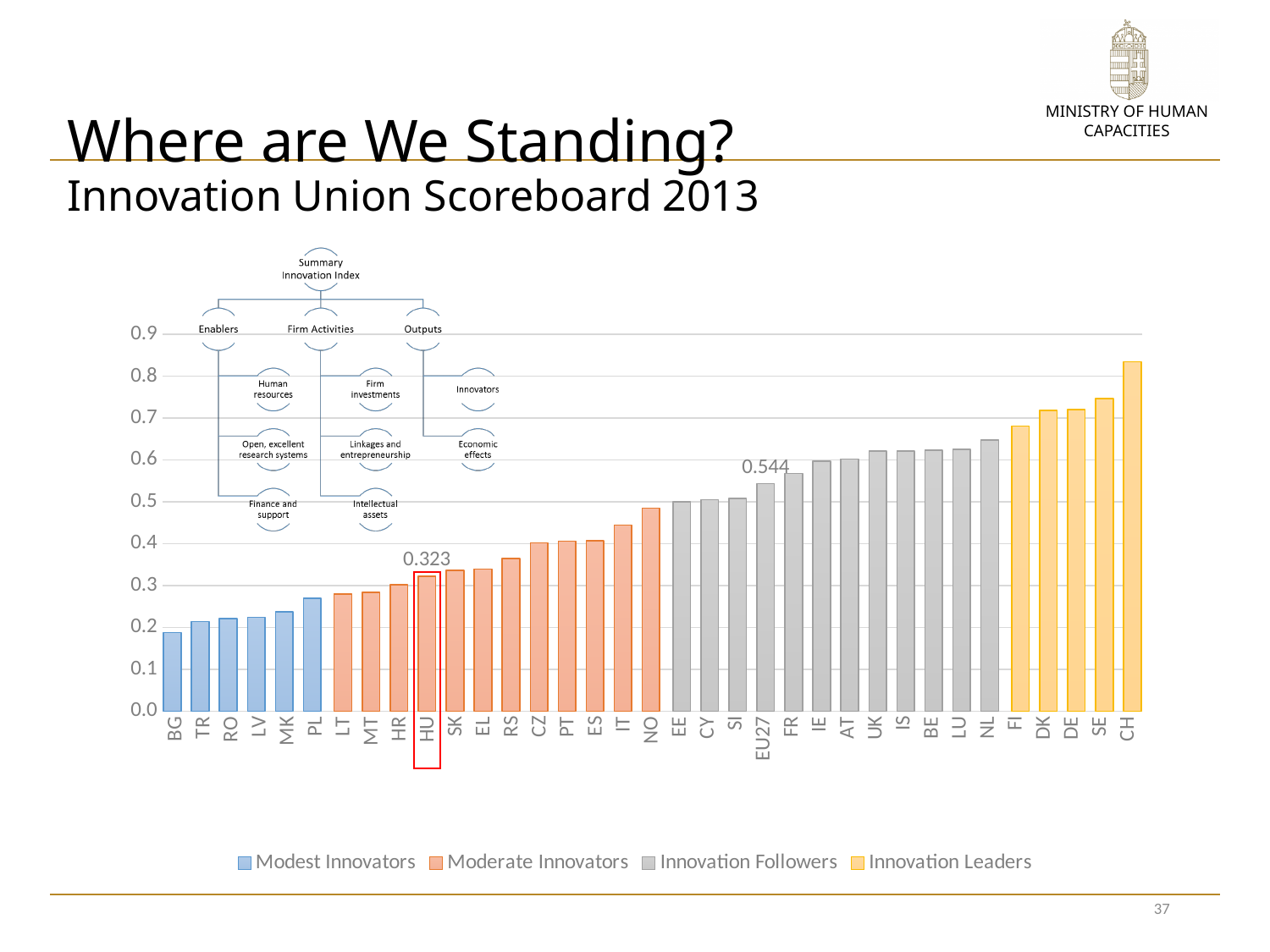
Which country has the lowest bar? BG Do the bar values rise or fall from left to right along the x axis? Rise What is the value shown for HU? 0.323 Which has a larger value, CH or BG? CH What kind of chart is shown on the slide? Bar chart Which country has the highest bar? CH What is the value shown for EU27? 0.544 Is the value for CH greater or less than 0.8? greater What is the difference between the EU27 value and the HU value? 0.221 Which legend group does HU belong to? Moderate Innovators How many series does the legend list? 4 Is the value for BG greater or less than 0.2? less